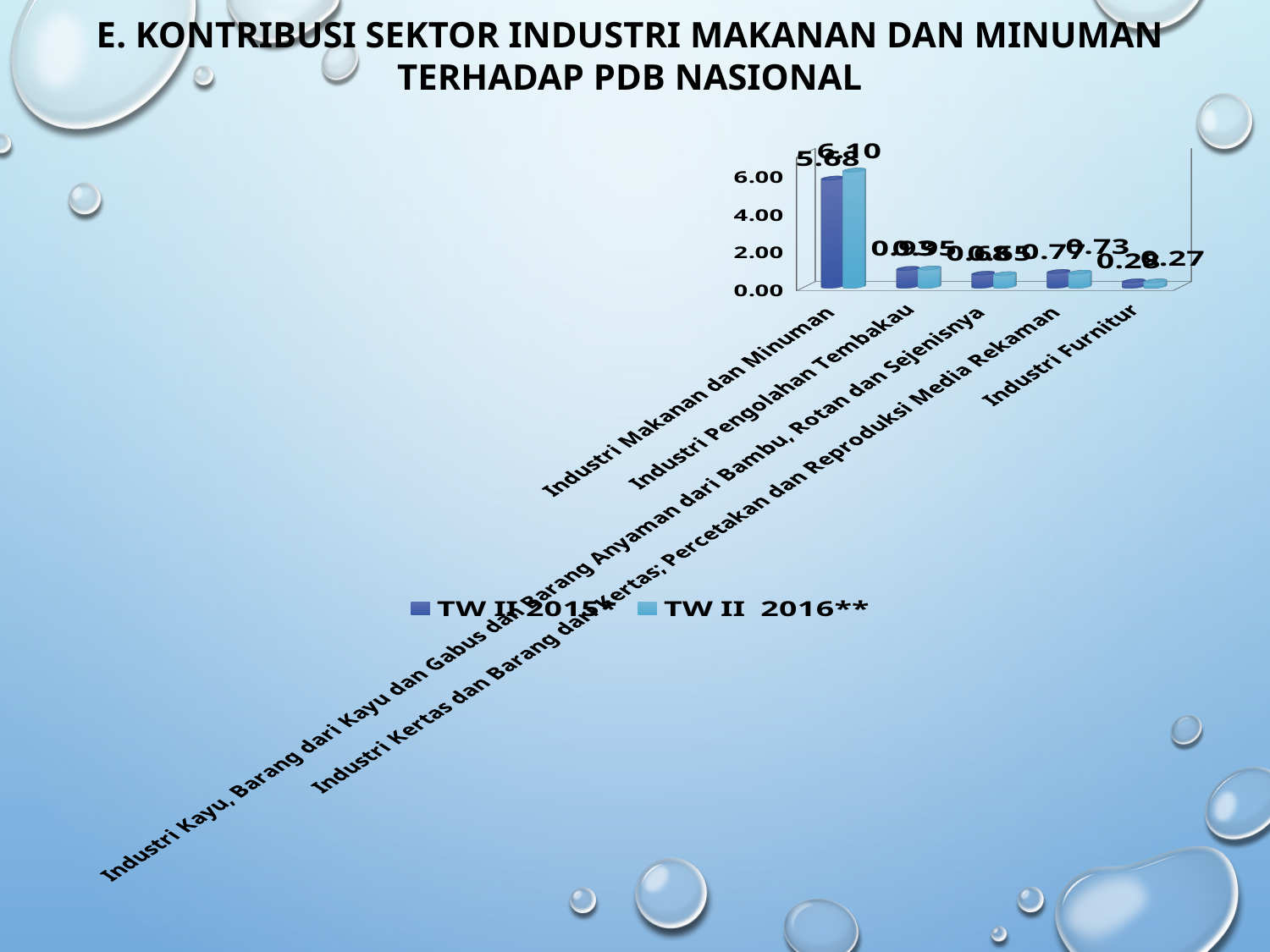
Which category has the highest values in the chart? Industri Makanan dan Minuman How many series does the legend list? 2 What is the value for Industri Furnitur in the TW II 2015* series? 0.28 What is the value for Industri Makanan dan Minuman in the TW II 2015* series? 5.68 What is the value for Industri Makanan dan Minuman in the TW II 2016** series? 6.10 What is the value for Industri Furnitur in the TW II 2016** series? 0.27 What is the difference between the TW II 2016** and TW II 2015* values for Industri Makanan dan Minuman? 0.42 How many categories are shown on the x axis of the chart? 5 What is the TW II 2015* value for Industri Kertas dan Barang dari Kertas; Percetakan dan Reproduksi Media Rekaman? 0.77 Which category has the lowest values in the chart? Industri Furnitur What kind of chart is shown on the slide? Bar chart For Industri Makanan dan Minuman, which series has the larger value, TW II 2015* or TW II 2016**? TW II 2016**